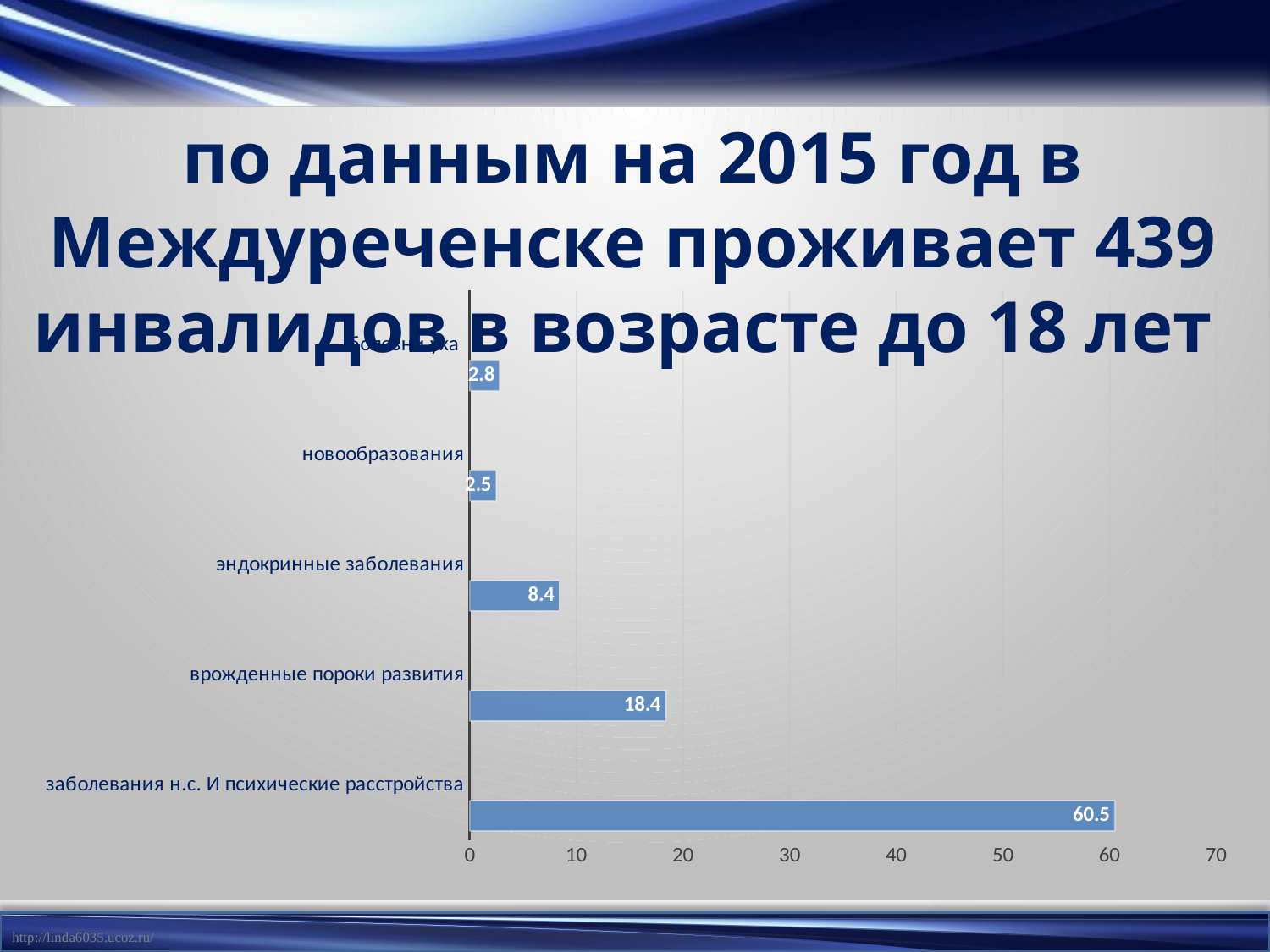
Which is larger: the value for "эндокринные заболевания" or the value for "врожденные пороки развития"? врожденные пороки развития What is the difference between the values for "заболевания н.с. И психические расстройства" and "врожденные пороки развития"? 42.1 What type of chart is shown on the slide? bar chart What is the value for "эндокринные заболевания"? 8.4 What is the value for "врожденные пороки развития"? 18.4 What is the value for "новообразования"? 2.5 Is the value for "заболевания н.с. И психические расстройства" greater or less than 50? greater What is the highest tick value shown on the horizontal axis? 70 How many bars are plotted in the chart? 5 Which category has the highest value? заболевания н.с. И психические расстройства Which category has the lowest value? новообразования What is the value for "заболевания н.с. И психические расстройства"? 60.5